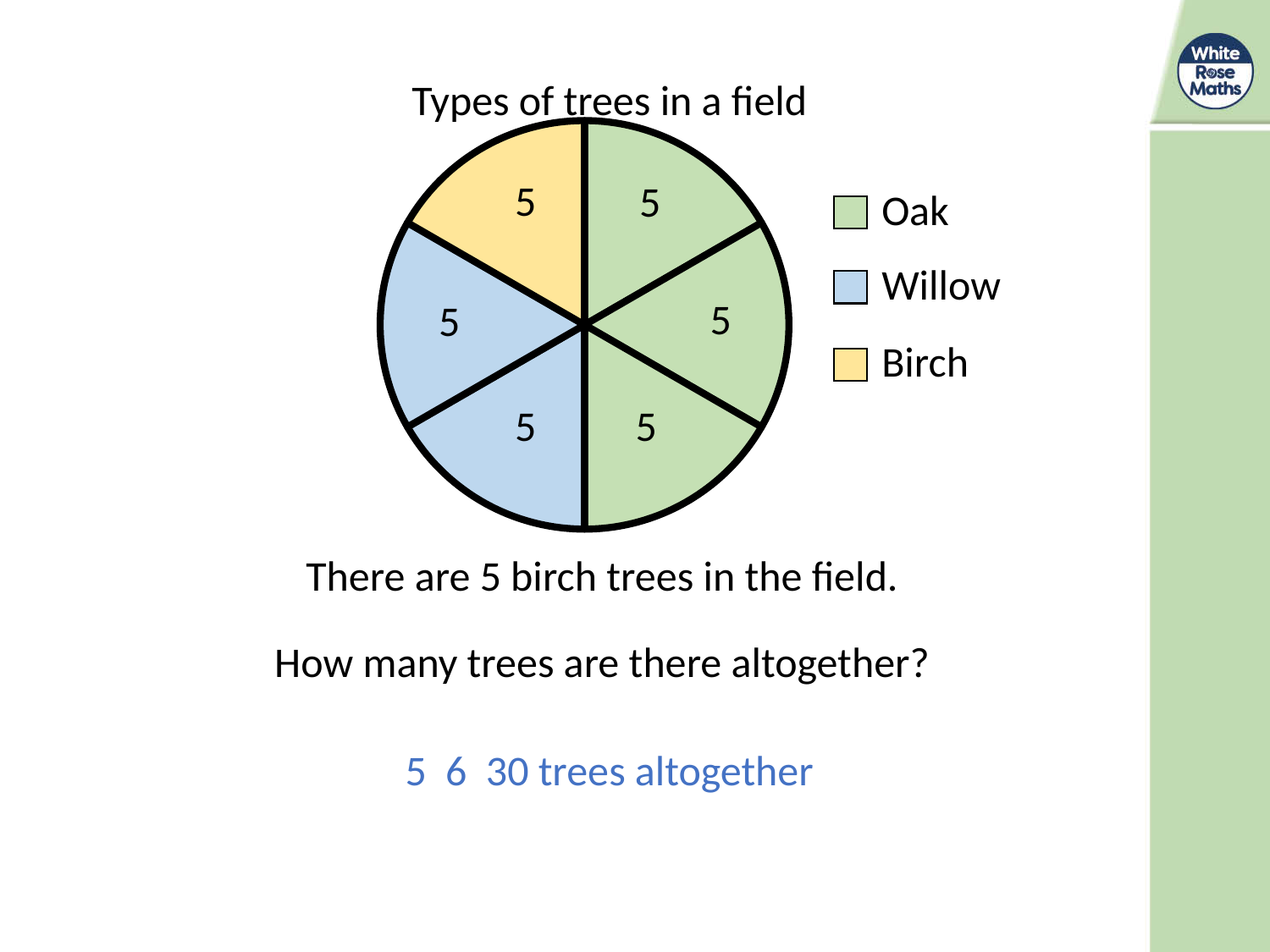
What is the title of the pie chart? Types of trees in a field How many oak trees are there in total, adding the oak slices? 15 How many entries does the legend of the pie chart list? 3 How many trees are there altogether according to the slide? 30 Which type of tree takes up the smallest part of the pie chart? Birch How many slices does the pie chart have? 6 How many willow trees are there in total, adding the willow slices? 10 What kind of chart is shown on the slide? Pie chart Which colour represents Willow in the pie chart? Blue Which type of tree takes up the largest part of the pie chart? Oak What value is printed in each slice of the pie chart? 5 What fraction of the pie chart does Birch represent? 1/6